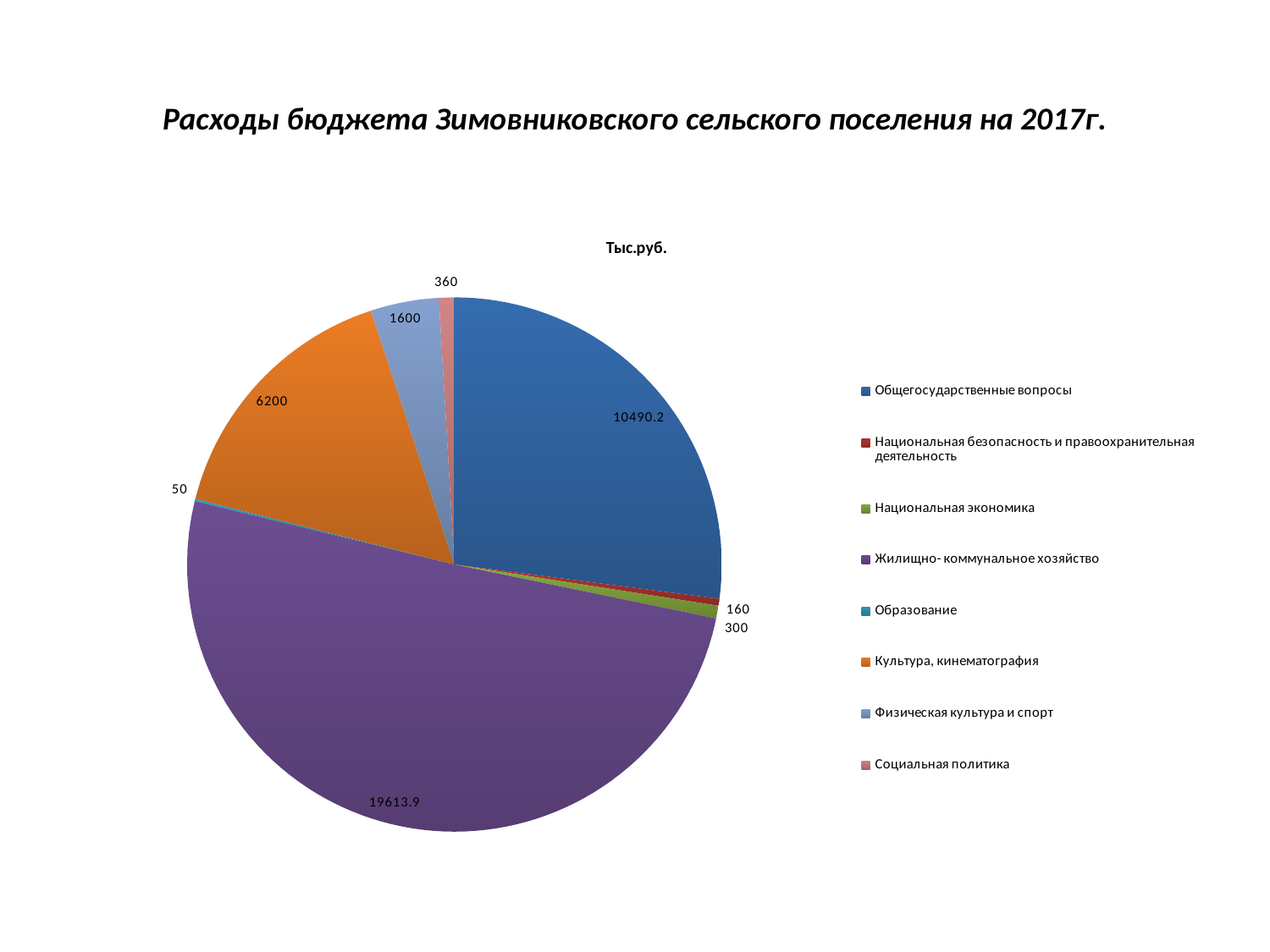
What is the difference between the values for Культура, кинематография and Физическая культура и спорт? 4600 Which is larger, Национальная экономика or Национальная безопасность и правоохранительная деятельность? Национальная экономика Which category has the largest slice of the pie? Жилищно- коммунальное хозяйство Which category has the smallest slice of the pie? Образование What is the value for Культура, кинематография? 6200 What is the difference between the values for Жилищно- коммунальное хозяйство and Общегосударственные вопросы? 9123.7 What is the value for Социальная политика? 360 What is the value for Образование? 50 What is the value for Жилищно- коммунальное хозяйство? 19613.9 How many categories does the legend list? 8 What kind of chart is shown on the slide? Pie chart What is the value for Общегосударственные вопросы? 10490.2